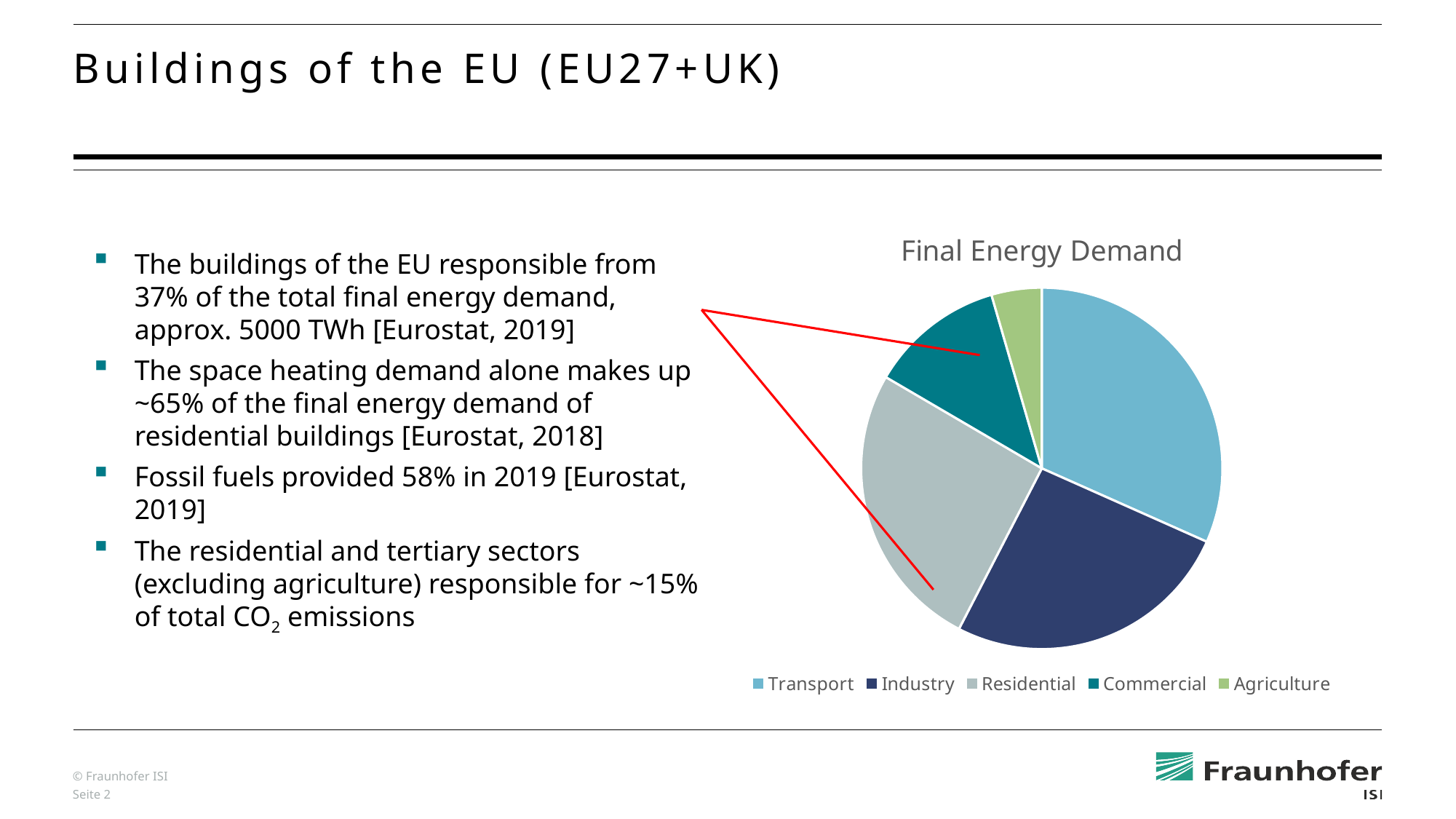
Which category has the largest slice of the pie? Transport Which category is shown in light green in the pie chart? Agriculture Which slice is larger, Residential or Commercial? Residential Which category has the smallest slice of the pie? Agriculture Which slice is larger, Commercial or Agriculture? Commercial What is the title of the chart? Final Energy Demand What kind of chart is shown on the slide? Pie chart How many entries does the legend list? 5 How many categories does the pie chart show? 5 Which slice is larger, Transport or Agriculture? Transport